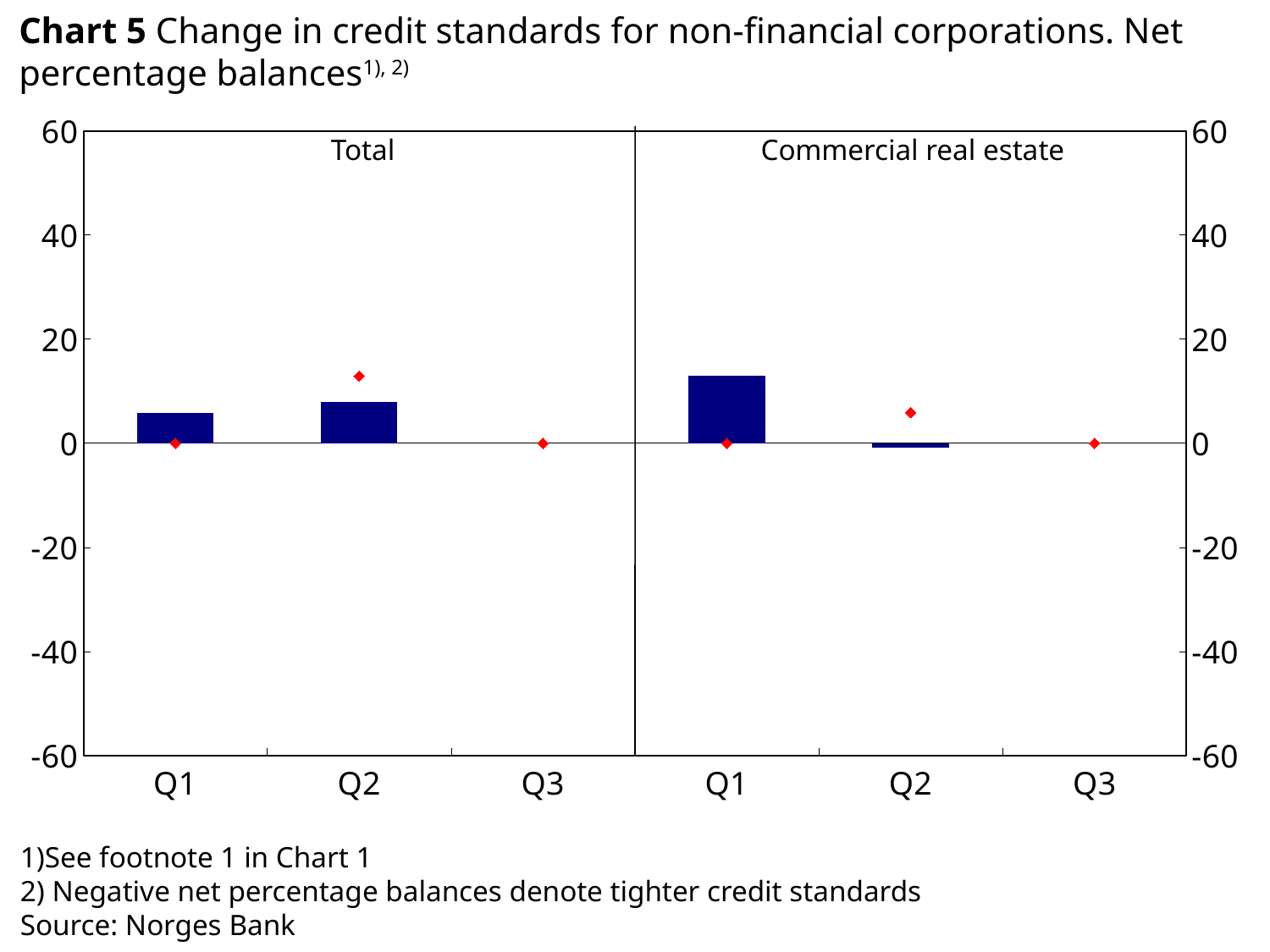
Is the Q2 bar in the Commercial real estate panel greater or less than 0? less What are the two panels of the chart labelled? Total and Commercial real estate In the Commercial real estate panel, which quarter has the highest bar? Q1 How many quarters are shown in the Total panel? 3 What is the source given for the chart? Norges Bank Is the Q2 bar in the Total panel greater or less than 20? less Is the Q1 bar in the Commercial real estate panel greater or less than 0? greater What kind of chart is shown on the slide? combination bar and line chart (bars with red diamond markers) In the Commercial real estate panel, which quarter has the lowest bar? Q2 In the Commercial real estate panel, which bar is larger, Q1 or Q2? Q1